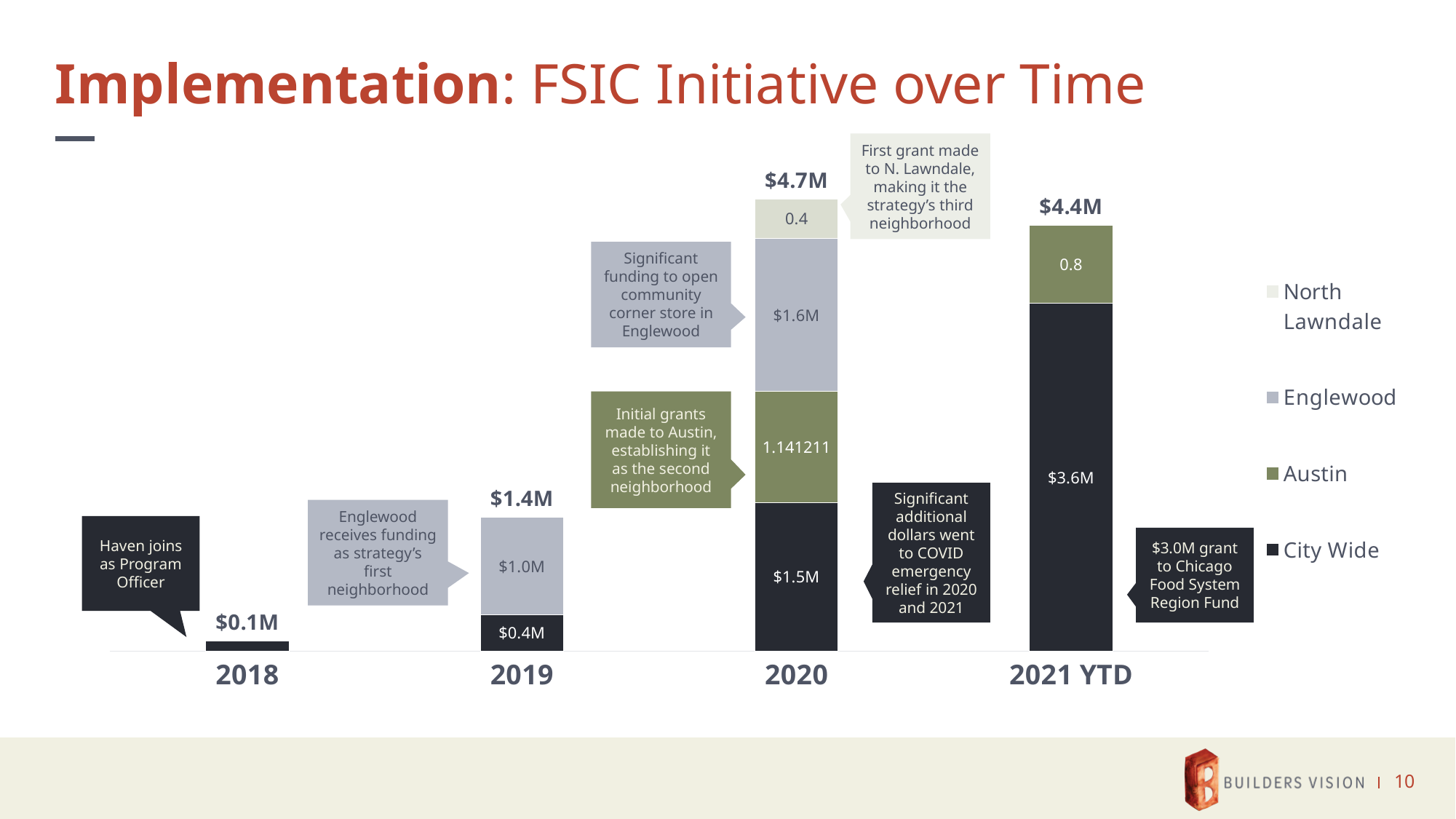
Which is larger, the City Wide value for 2021 YTD or the City Wide value for 2020? 2021 YTD How many years are shown on the x axis? 4 What is the difference between the total for 2020 and the total for 2021 YTD? $0.3M How many series does the legend list? 4 What is the City Wide value for 2020? $1.5M Which year has the highest total value? 2020 What is the North Lawndale value for 2020? 0.4 What kind of chart is shown on the slide? Stacked bar chart What is the total value shown above the bar for 2020? $4.7M What is the Englewood value for 2019? $1.0M Which year has the lowest total value? 2018 What is the City Wide value for 2021 YTD? $3.6M